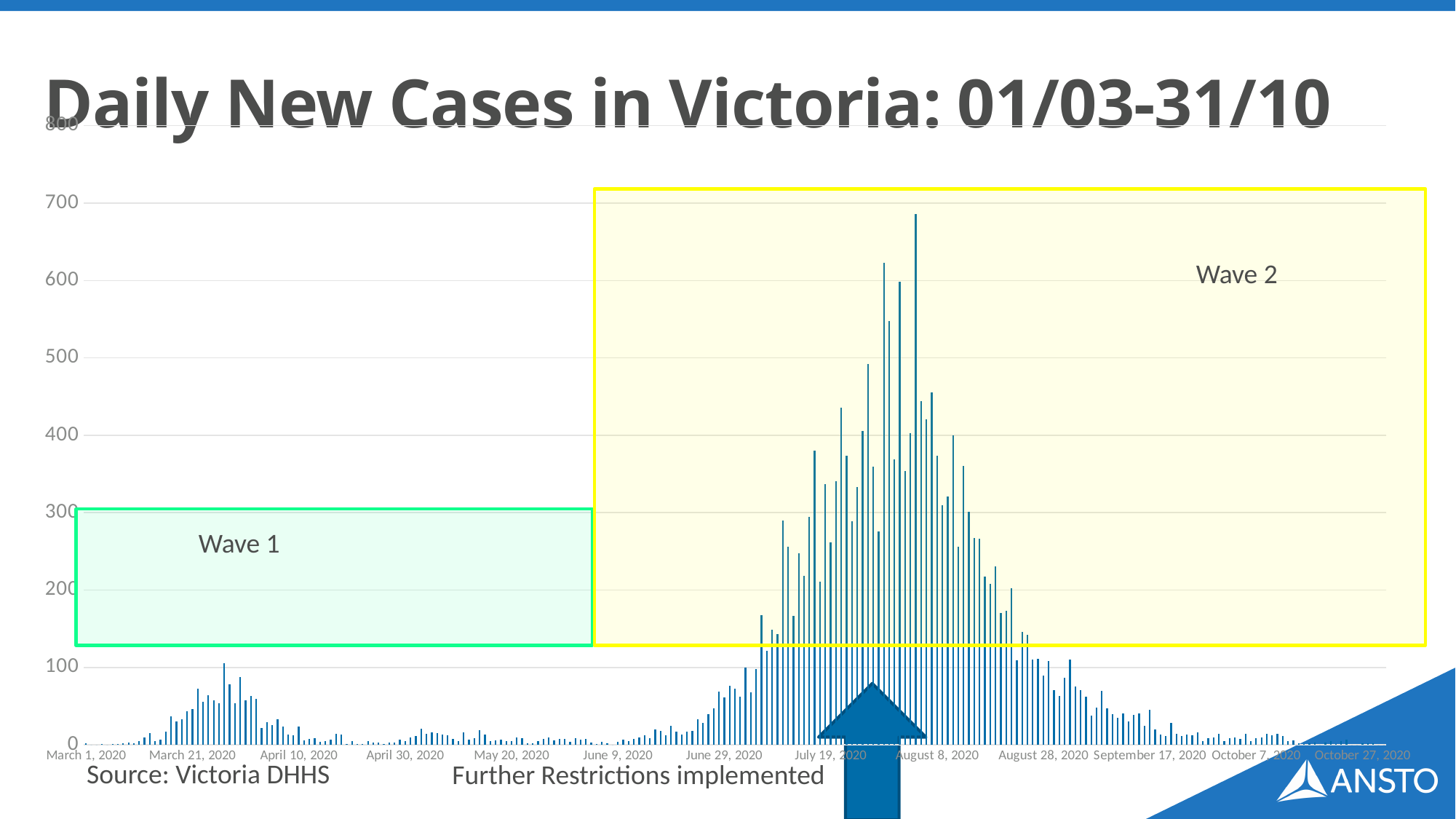
Is the highest daily value during Wave 1 greater or less than 200? less How many date labels are shown along the x axis? 13 Is the value on May 20, 2020 greater or less than 100? less What is the title of the chart? Daily New Cases in Victoria: 01/03-31/10 Do daily new cases rise or fall between August 8, 2020 and September 17, 2020? fall What is the highest value shown on the vertical axis? 800 Which wave has the higher peak of daily new cases, Wave 1 or Wave 2? Wave 2 Do daily new cases rise or fall between June 29, 2020 and July 19, 2020? rise What kind of chart is shown on the slide? bar chart Is the highest daily value in the chart greater or less than 600? greater